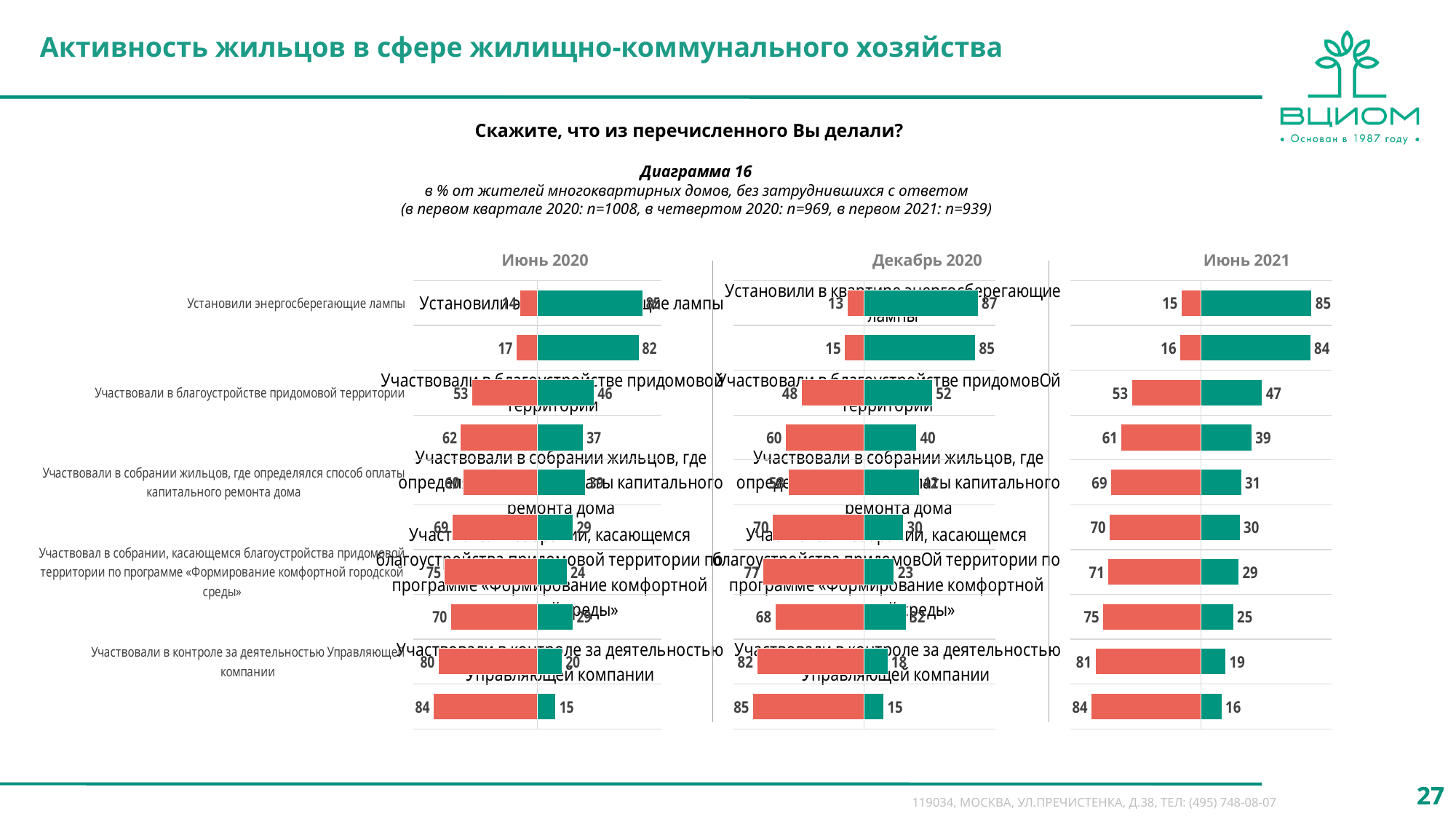
What kind of chart is used on this slide? bar chart How many separate charts are shown on the slide? 3 In the Июнь 2021 chart, what is the largest green value? 85 In the Июнь 2021 chart, do the green values rise or fall going from the top row to the bottom row? fall In the Июнь 2021 chart, what is the green value in the top row? 85 In the Июнь 2021 chart, what is the red value in the top row? 15 What are the titles of the three charts on the slide? Июнь 2020, Декабрь 2020, Июнь 2021 In the Июнь 2021 chart, what is the green value in the bottom row? 16 In the Июнь 2021 chart, what is the smallest green value? 16 In the Июнь 2021 chart, what is the difference between the green and red values in the top row? 70 In the Июнь 2021 chart, what is the red value in the bottom row? 84 In the Декабрь 2020 chart, which is larger in the bottom row, the red value or the green value? the red value